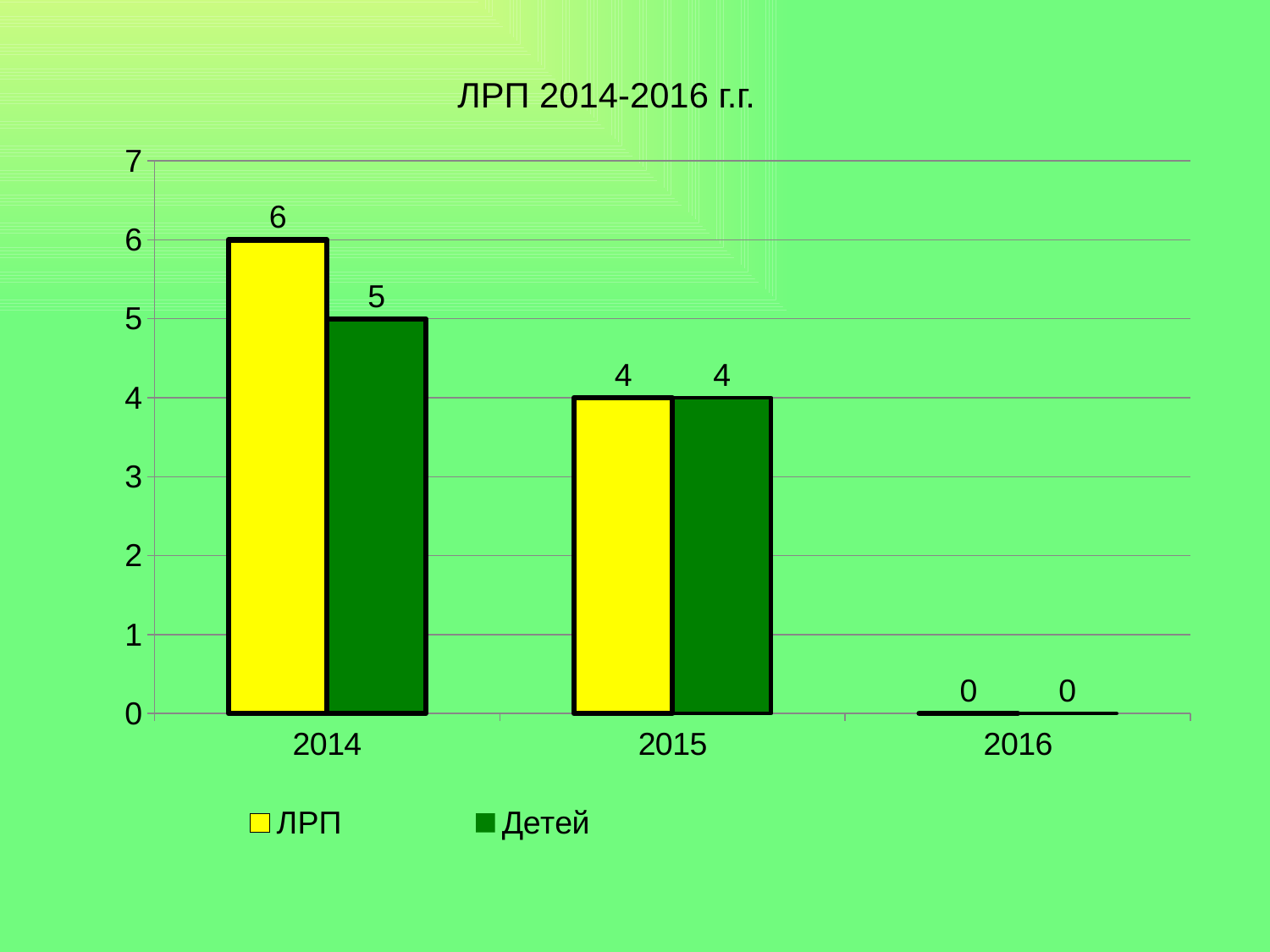
What is the difference between the ЛРП and Детей values in 2014? 1 How many years are shown on the x axis? 3 Which year has the lowest value for Детей? 2016 What is the value for Детей in 2014? 5 How many series does the legend list? 2 Which is larger in 2014, the value for ЛРП or the value for Детей? ЛРП What is the value for ЛРП in 2014? 6 Which year has the highest value for ЛРП? 2014 What is the value for ЛРП in 2015? 4 Do the values for ЛРП rise or fall from 2014 to 2016? Fall What is the value for Детей in 2016? 0 What kind of chart is shown on the slide? Bar chart